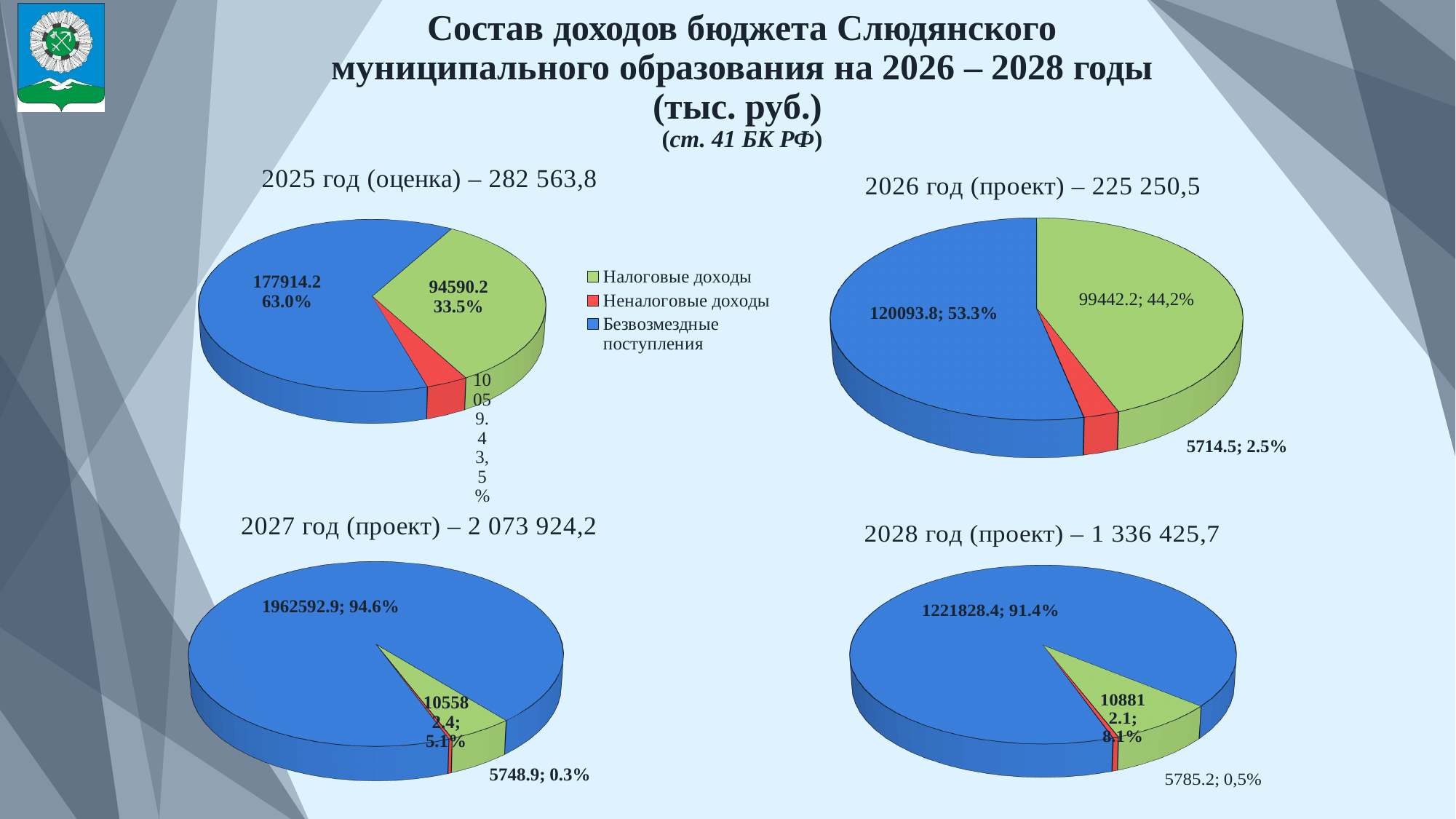
What kind of chart is used for the 2027 год (проект) data? Pie chart In the 2027 год (проект) chart, what is the value for Неналоговые доходы? 5748.9 In the 2027 год (проект) chart, what share of the pie is Безвозмездные поступления? 94.6% In the 2025 год (оценка) chart, what is the value for Налоговые доходы? 94590.2 In the 2028 год (проект) chart, which category is the smallest? Неналоговые доходы In the 2026 год (проект) chart, what is the value for Безвозмездные поступления? 120093.8 How many entries does the legend list? 3 In the 2026 год (проект) chart, which is larger: Безвозмездные поступления or Налоговые доходы? Безвозмездные поступления In the 2026 год (проект) chart, what share of the pie is Налоговые доходы? 44,2% In the 2025 год (оценка) chart, what share of the pie is Безвозмездные поступления? 63.0% In the 2028 год (проект) chart, what is the value for Безвозмездные поступления? 1221828.4 In the 2026 год (проект) chart, which category is the largest? Безвозмездные поступления